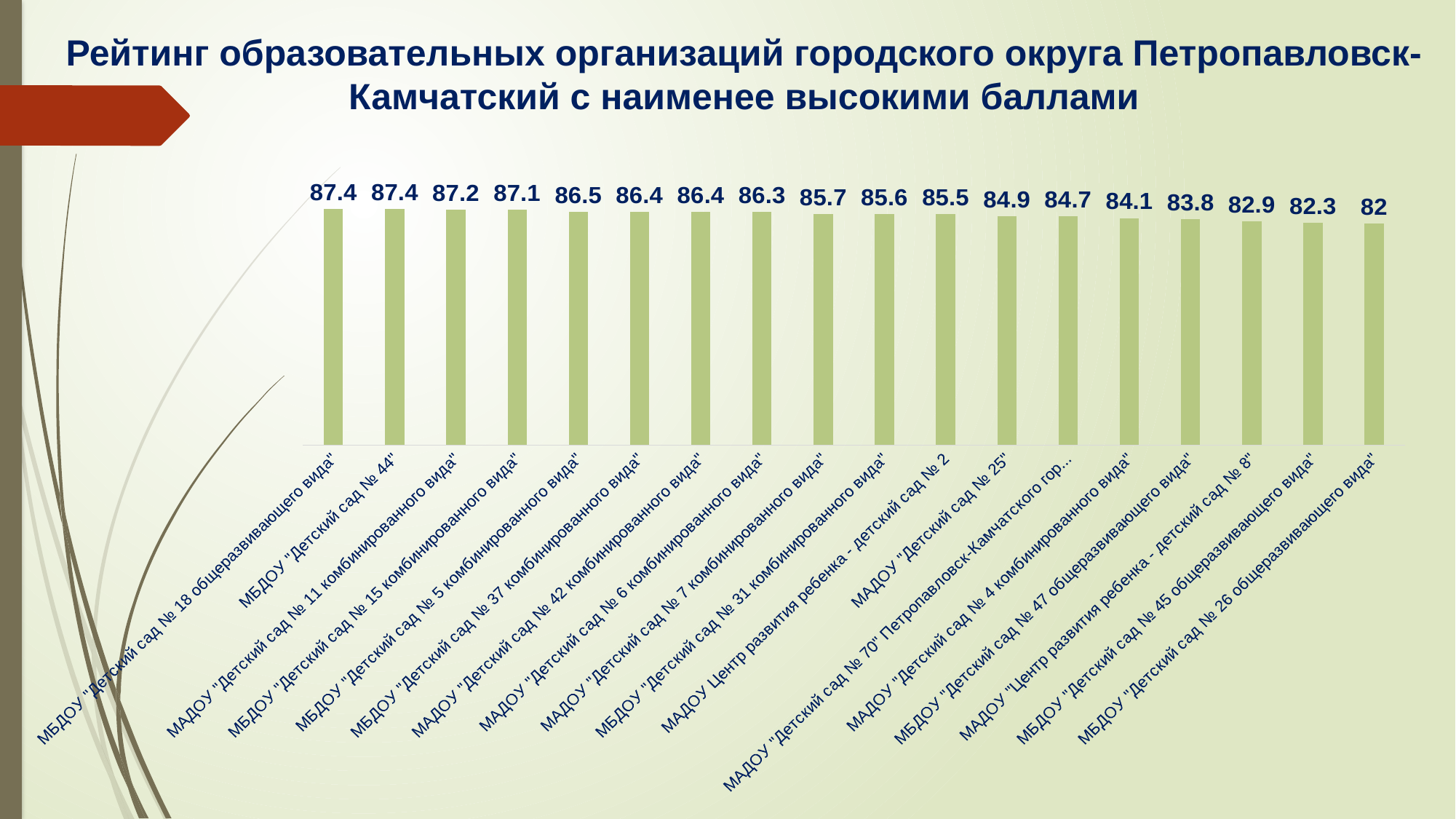
What type of chart is shown on the slide? Bar chart What is the value for МАДОУ "Детский сад № 25"? 84.9 What is the value for МАДОУ "Центр развития ребенка - детский сад № 8"? 82.9 What is the value for МБДОУ "Детский сад № 44"? 87.4 Which has a larger value: МБДОУ "Детский сад № 44" or МАДОУ "Детский сад № 25"? МБДОУ "Детский сад № 44" How many organisations (bars) are shown in the chart? 18 Which organisation has the lowest value in the chart? МБДОУ "Детский сад № 26 общеразвивающего вида" Do the values rise or fall from left to right along the x axis? Fall What is the highest value shown in the chart? 87.4 What is the title of the chart on the slide? Рейтинг образовательных организаций городского округа Петропавловск-Камчатский с наименее высокими баллами What is the difference between the value for МБДОУ "Детский сад № 18 общеразвивающего вида" and the value for МБДОУ "Детский сад № 26 общеразвивающего вида"? 5.4 What is the value for МБДОУ "Детский сад № 47 общеразвивающего вида"? 83.8